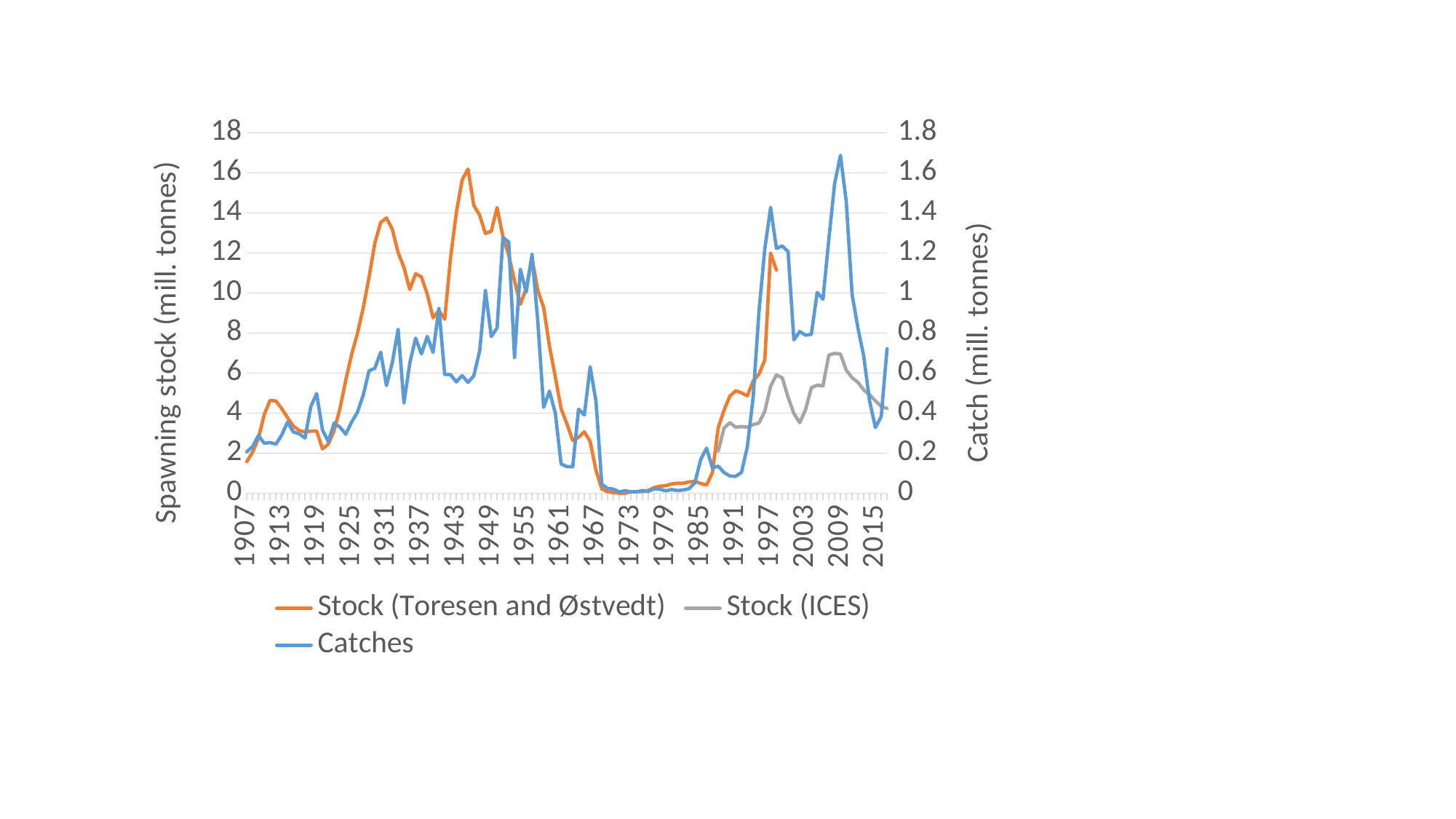
What kind of chart is shown on the slide? line chart What is the title of the left vertical axis? Spawning stock (mill. tonnes) Does the Stock (Toresen and Østvedt) line rise or fall between 1955 and 1973? fall Is the value of Stock (Toresen and Østvedt) around 1973 greater or less than 2 on the left axis? less Which is higher for Catches: the peak around 1997 or the peak around 2009? the peak around 2009 Is the peak value of Stock (Toresen and Østvedt) around 1945 greater or less than 14 on the left axis? greater Is the value of Stock (ICES) around 1991 greater or less than 4 on the left axis? less Does the Stock (Toresen and Østvedt) line rise or fall between 1919 and 1931? rise What is the title of the right vertical axis? Catch (mill. tonnes) Does the Catches line rise or fall between 1973 and 1997? rise How many series does the legend list? 3